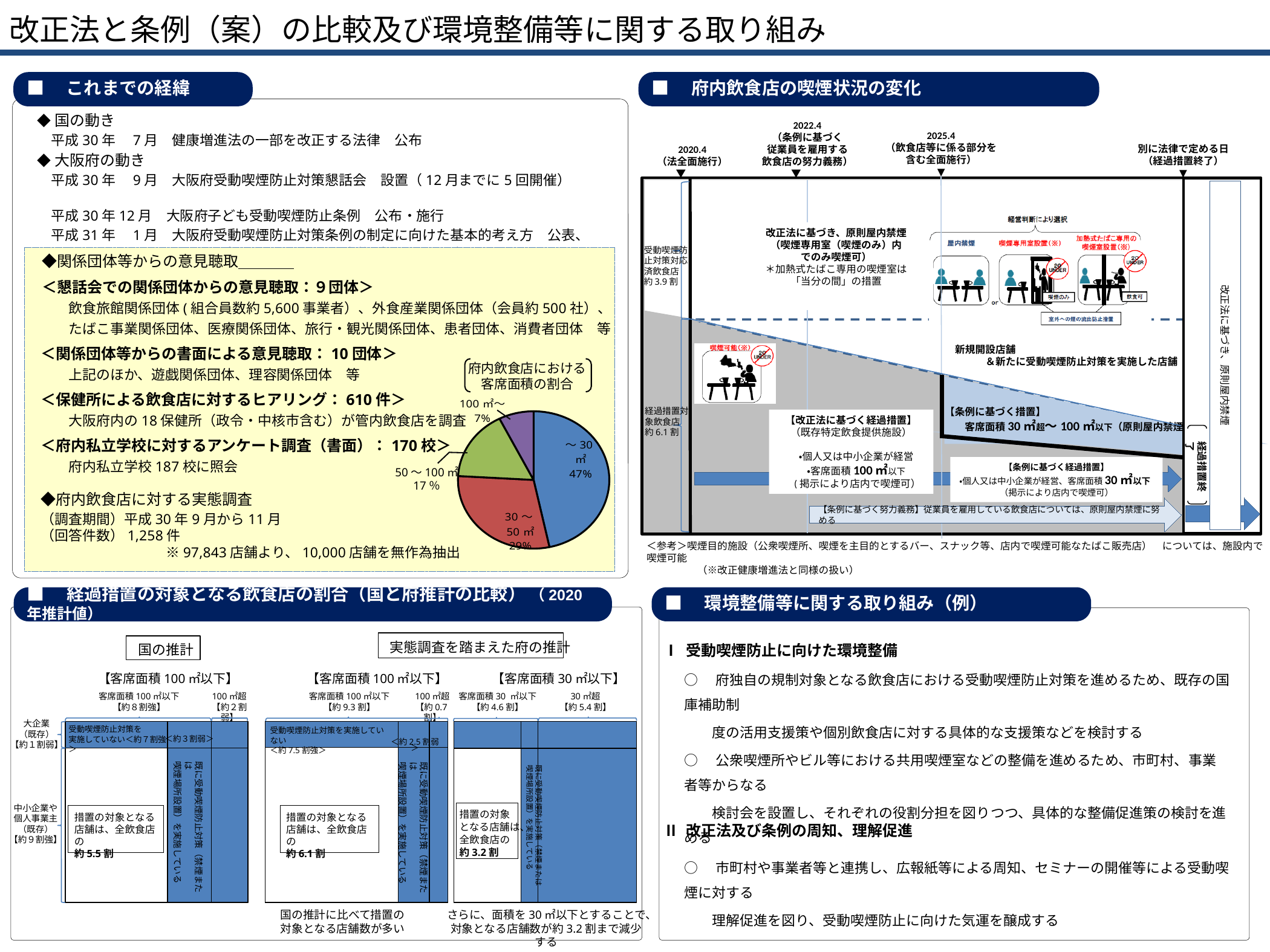
In the pie chart 府内飲食店における客席面積の割合, what share do restaurants with seating area ～30㎡ have? 47% In the pie chart 府内飲食店における客席面積の割合, what is the combined share of the 50～100㎡ and 100㎡～ slices? 24% In the pie chart 府内飲食店における客席面積の割合, what colour is the ～30㎡ slice? blue In the pie chart 府内飲食店における客席面積の割合, which is larger: the share for 50～100㎡ or the share for 100㎡～? 50～100㎡ In the pie chart 府内飲食店における客席面積の割合, which seating-area category has the largest share? ～30㎡ In the pie chart 府内飲食店における客席面積の割合, what is the difference in percentage points between the ～30㎡ slice and the 50～100㎡ slice? 30 In the pie chart 府内飲食店における客席面積の割合, which seating-area category has the smallest share? 100㎡～ In the pie chart 府内飲食店における客席面積の割合, what share do restaurants with seating area 50～100㎡ have? 17% In the pie chart 府内飲食店における客席面積の割合, what share do restaurants with seating area 30～50㎡ have? 29% In the pie chart 府内飲食店における客席面積の割合, how many slices are there? 4 In the pie chart 府内飲食店における客席面積の割合, what share do restaurants with seating area 100㎡～ have? 7% What kind of chart is the chart titled 府内飲食店における客席面積の割合? pie chart